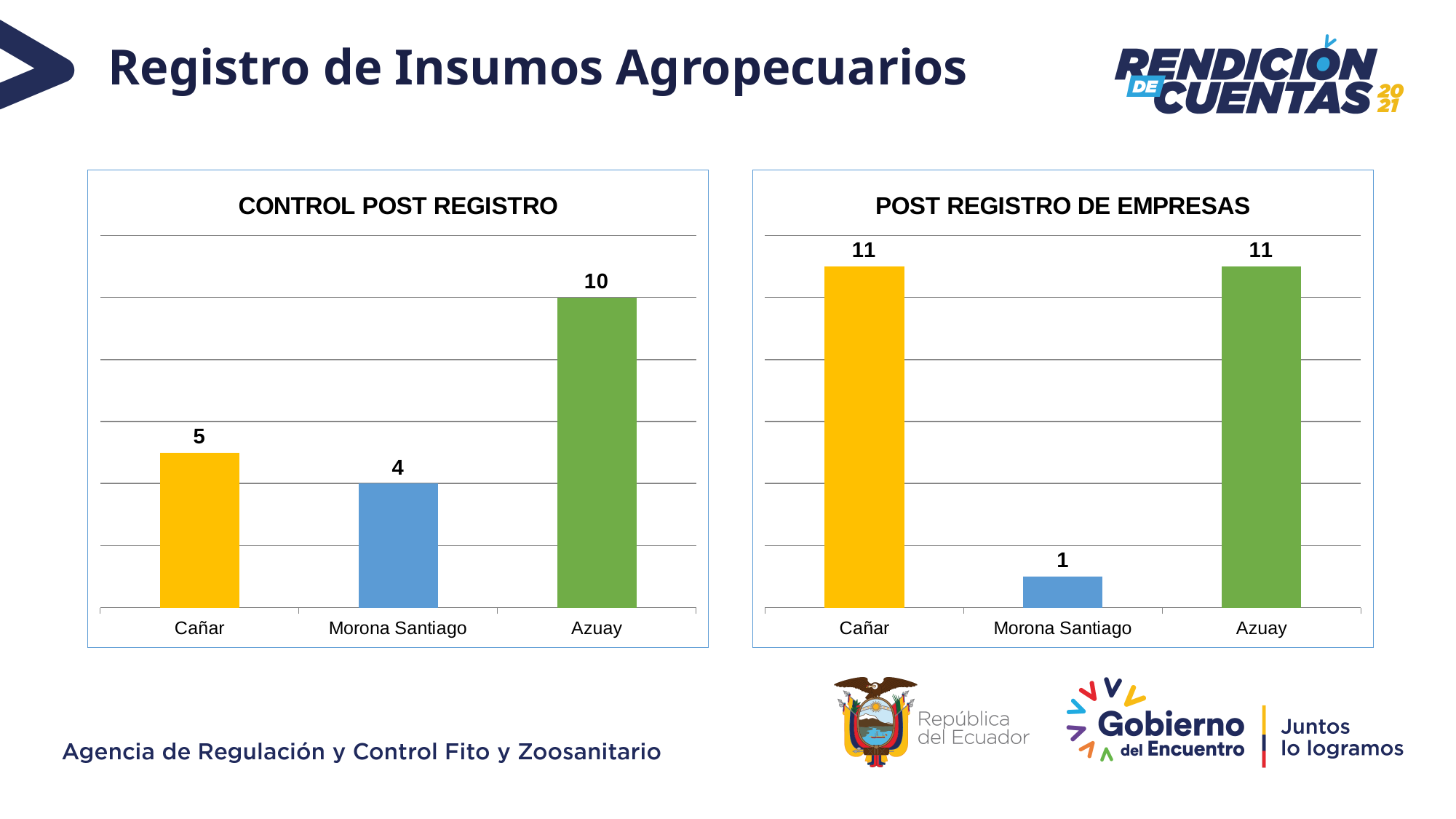
In the CONTROL POST REGISTRO chart, what is the value for Morona Santiago? 4 In the CONTROL POST REGISTRO chart, what is the value for Azuay? 10 In the POST REGISTRO DE EMPRESAS chart, what is the value for Cañar? 11 How many categories are shown in the POST REGISTRO DE EMPRESAS chart? 3 In the CONTROL POST REGISTRO chart, which category has the highest value? Azuay What type of chart is the CONTROL POST REGISTRO chart? Bar chart In the POST REGISTRO DE EMPRESAS chart, what is the difference between the values for Azuay and Morona Santiago? 10 In the POST REGISTRO DE EMPRESAS chart, what is the value for Morona Santiago? 1 In the CONTROL POST REGISTRO chart, which is larger, the value for Cañar or the value for Morona Santiago? Cañar In the CONTROL POST REGISTRO chart, which category has the lowest value? Morona Santiago In the CONTROL POST REGISTRO chart, what is the difference between the values for Azuay and Cañar? 5 In the POST REGISTRO DE EMPRESAS chart, which category has the lowest value? Morona Santiago